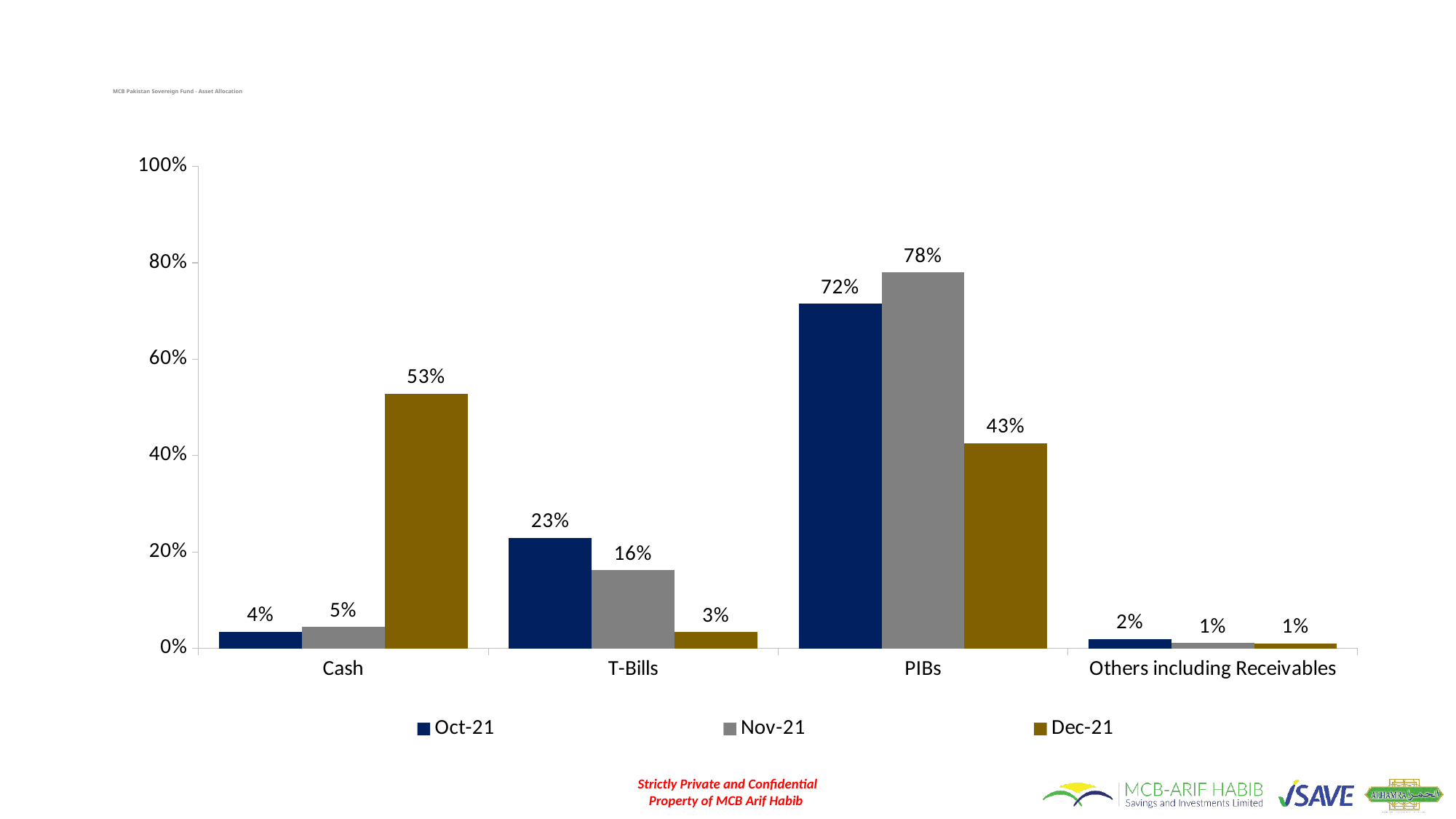
What is the Dec-21 value for Cash? 53% What is the Oct-21 value for T-Bills? 23% Which series is shown in gray in the legend? Nov-21 How many categories are shown on the x axis? 4 What is the Nov-21 value for PIBs? 78% How many series does the legend list? 3 Which category has the highest Oct-21 value? PIBs What is the Dec-21 value for Others including Receivables? 1% What is the difference between the Nov-21 and Dec-21 values for PIBs? 35% What kind of chart is shown on the slide? Bar chart Which category has the lowest Dec-21 value? Others including Receivables Which is larger for T-Bills: the Oct-21 value or the Nov-21 value? Oct-21